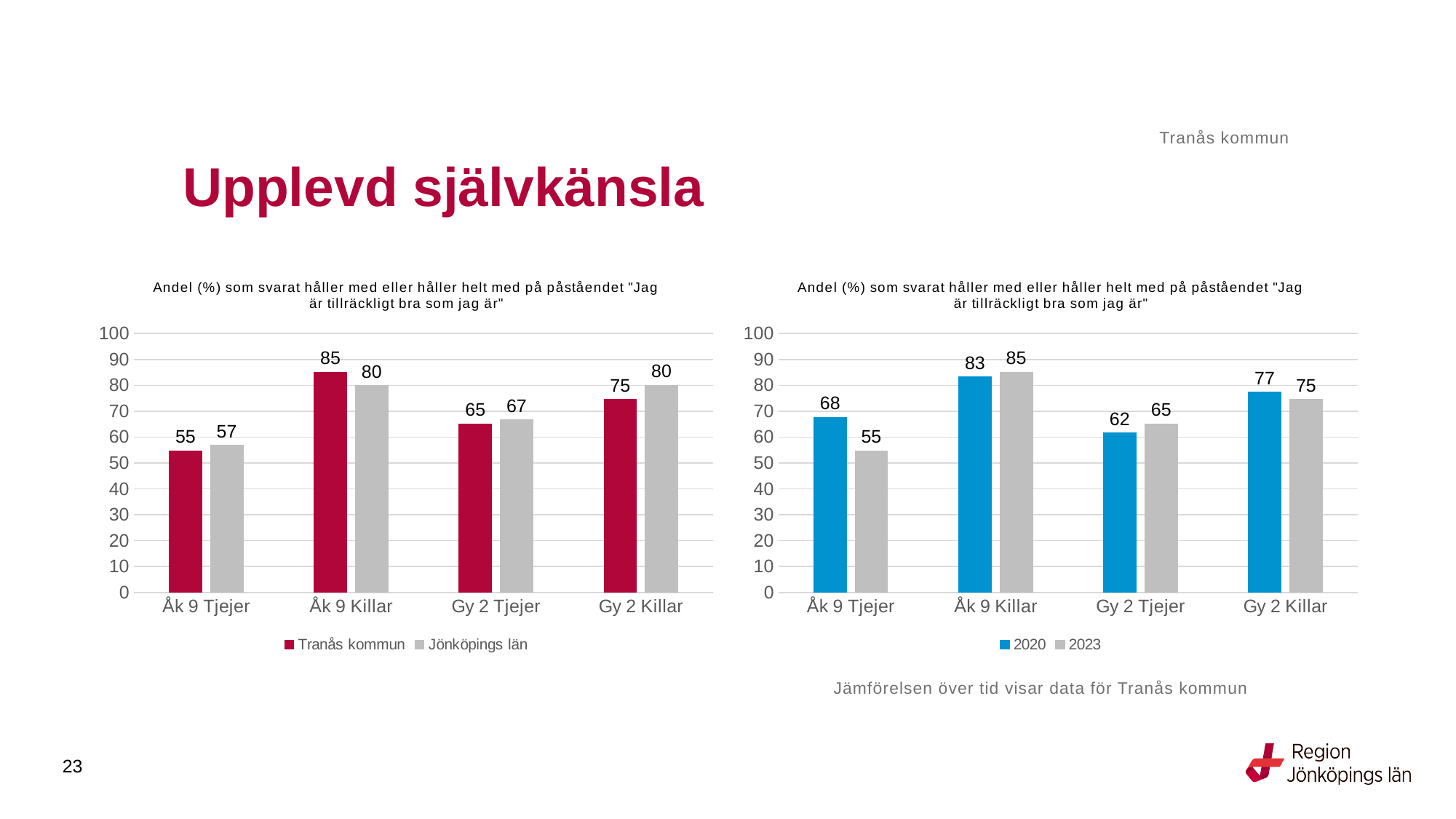
What type of chart is the left chart? Bar chart In the left chart, what is the value for Jönköpings län for Gy 2 Tjejer? 67 In the right chart, what is the value for 2023 for Åk 9 Tjejer? 55 In the left chart, what is the difference between Jönköpings län and Tranås kommun for Gy 2 Killar? 5 In the right chart, which category has the lowest value for 2023? Åk 9 Tjejer In the right chart, what is the value for 2020 for Gy 2 Killar? 77 In the right chart, which is larger for Gy 2 Tjejer: 2020 or 2023? 2023 In the right chart, what is the difference between 2020 and 2023 for Åk 9 Tjejer? 13 In the left chart, which category has the highest value for Tranås kommun? Åk 9 Killar In the left chart, what is the value for Tranås kommun for Åk 9 Killar? 85 How many categories are shown on the x axis of the left chart? 4 How many series does the legend of the right chart list? 2